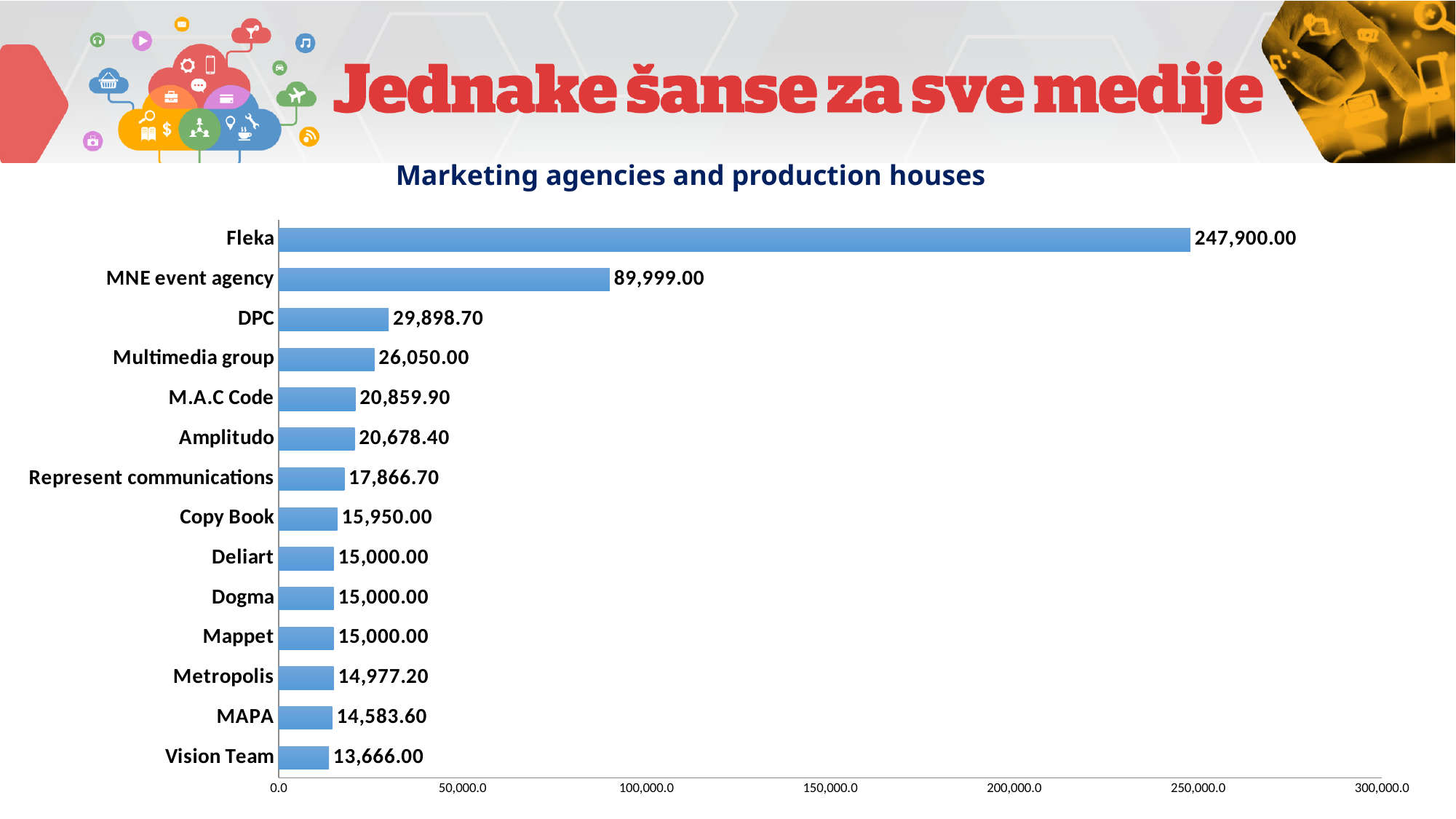
What is the value for Fleka? 247,900.00 Which is larger, the value for MNE event agency or the value for DPC? MNE event agency What kind of chart is shown on the slide? bar chart What is the value for MAPA? 14,583.60 How many categories are shown in the chart? 14 Which category has the lowest value? Vision Team Which category has the highest value? Fleka What is the title of the chart? Marketing agencies and production houses What is the value for Represent communications? 17,866.70 Is the value for MNE event agency greater or less than 100,000.0? less What is the difference between the values for DPC and Multimedia group? 3,848.70 What is the difference between the values for Fleka and MNE event agency? 157,901.00